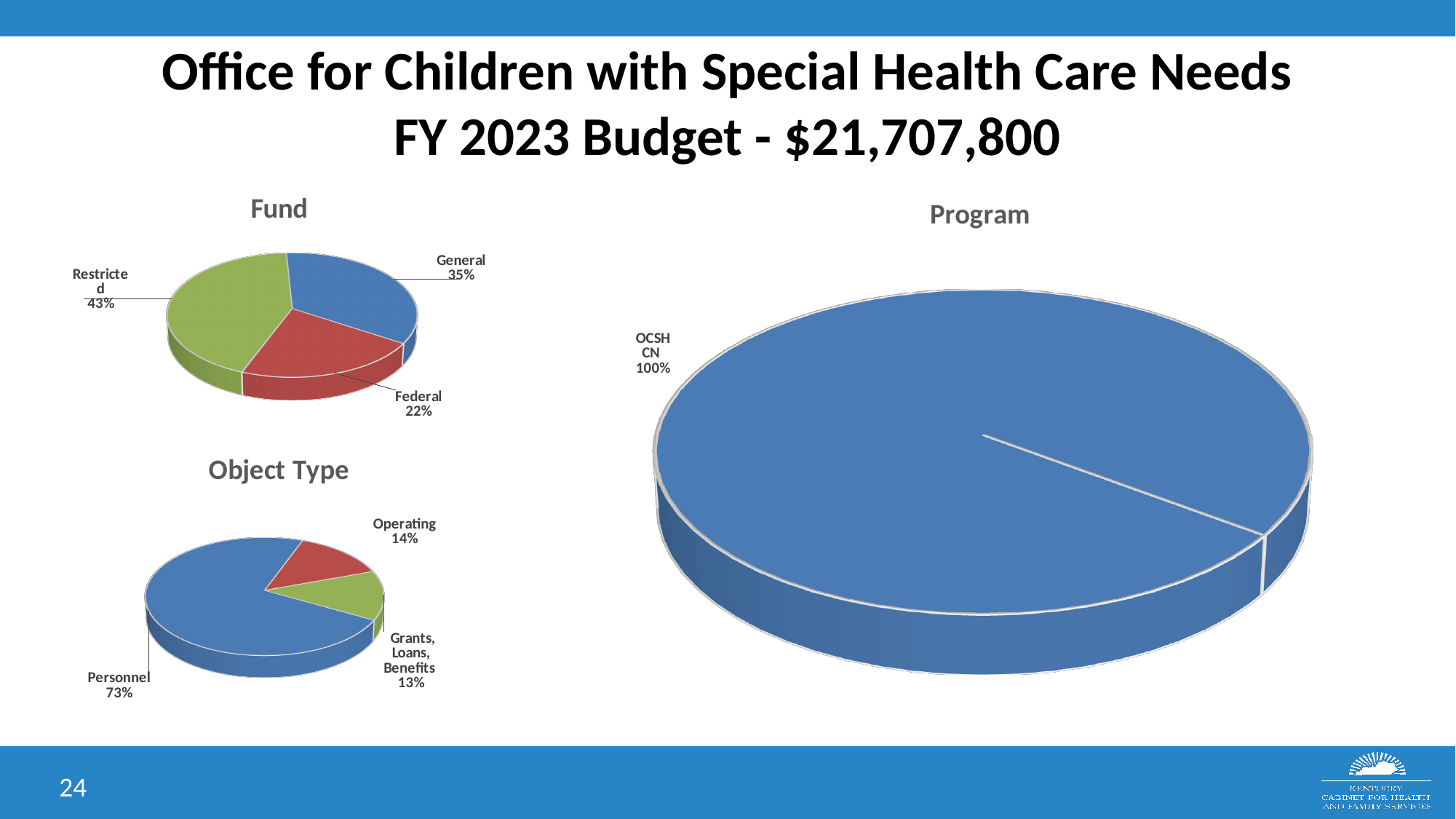
In the Fund chart, which fund source has the largest share? Restricted In the Object Type chart, what share is Personnel? 73% In the Program chart, what share is labelled for OCSHCN? 100% How many slices does the Object Type chart have? 3 In the Fund chart, which fund source has the smallest share? Federal In the Fund chart, what share of the budget comes from Restricted funds? 43% In the Fund chart, what is the difference in percentage points between General and Federal? 13 In the Object Type chart, which is larger, Operating or Grants, Loans, Benefits? Operating What is the title of the chart in the top left of the slide? Fund In the Object Type chart, what percentage is Grants, Loans, Benefits? 13% In the Fund chart, what percentage is labelled for Federal? 22% What kind of chart is the Program chart? Pie chart